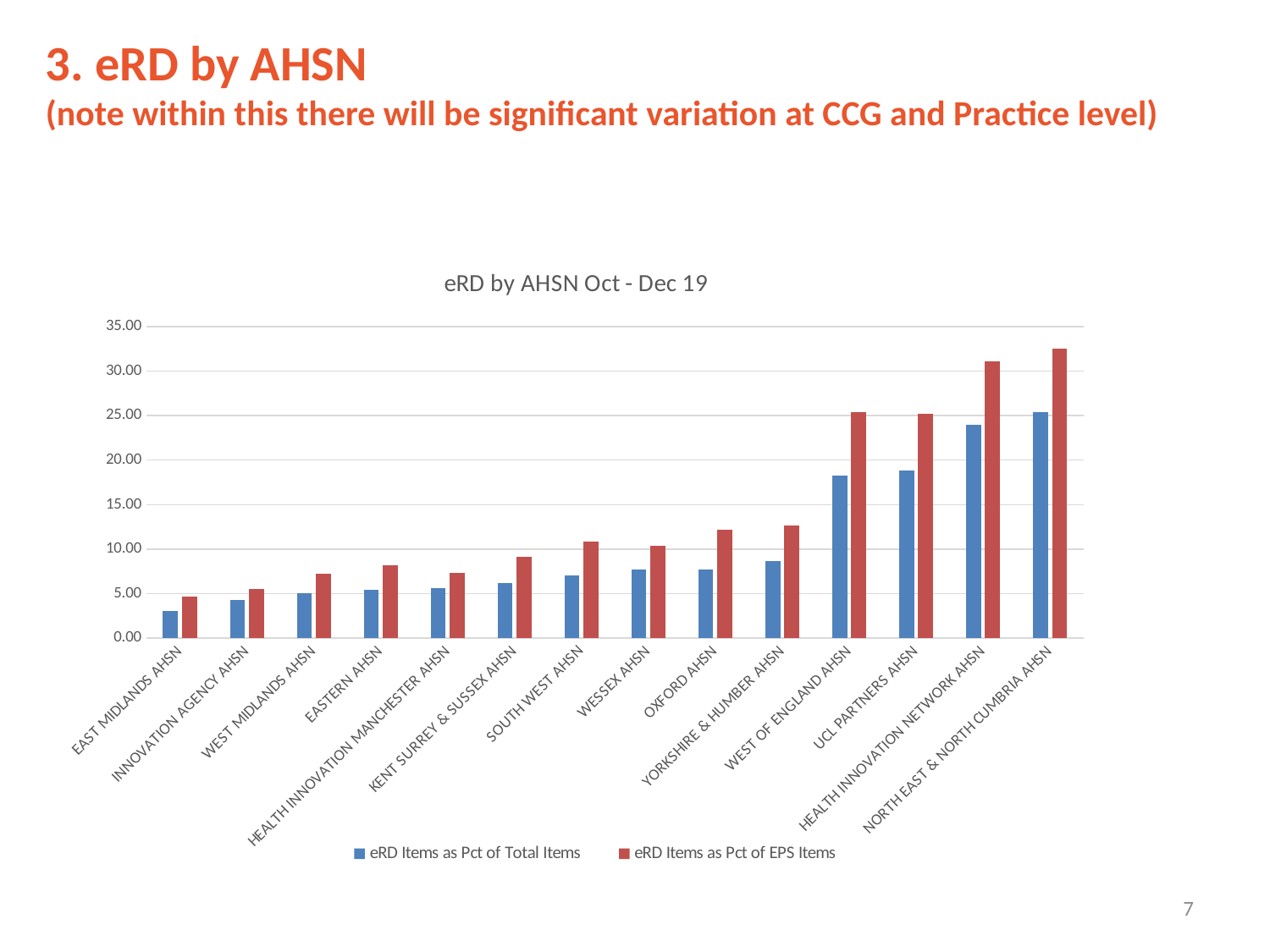
How many AHSN categories are shown on the x axis? 14 Which AHSN has the highest value for eRD Items as Pct of EPS Items? NORTH EAST & NORTH CUMBRIA AHSN What type of chart is shown on the slide? Bar chart Is the eRD Items as Pct of Total Items value for YORKSHIRE & HUMBER AHSN greater or less than 10.00? less Is the eRD Items as Pct of EPS Items value for WEST OF ENGLAND AHSN greater or less than 20.00? greater How many series does the legend list? 2 Which is larger: the eRD Items as Pct of EPS Items value for OXFORD AHSN or for WESSEX AHSN? OXFORD AHSN Is the eRD Items as Pct of Total Items value for EAST MIDLANDS AHSN greater or less than 5.00? less Which AHSN has the lowest value for eRD Items as Pct of Total Items? EAST MIDLANDS AHSN What is the title of the chart? eRD by AHSN Oct - Dec 19 Do the eRD Items as Pct of Total Items values generally rise or fall moving left to right along the x axis? rise